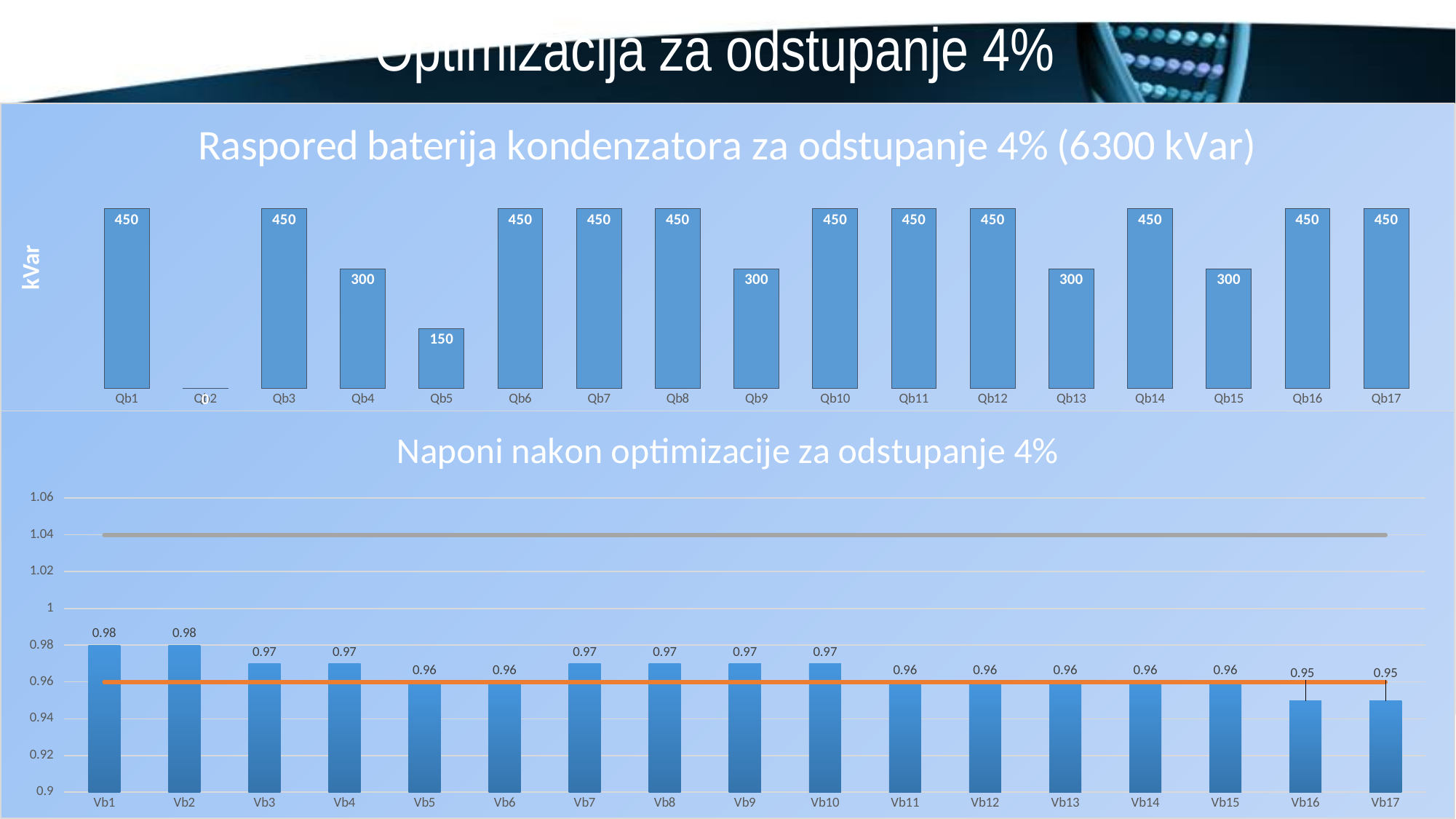
In the chart 'Naponi nakon optimizacije za odstupanje 4%', do the bar values generally rise or fall from Vb1 to Vb17? Fall In the chart 'Raspored baterija kondenzatora za odstupanje 4% (6300 kVar)', how many categories are shown on the x axis? 17 In the chart 'Naponi nakon optimizacije za odstupanje 4%', what is the difference between the values for Vb1 and Vb17? 0.03 In the chart 'Raspored baterija kondenzatora za odstupanje 4% (6300 kVar)', which category has the lowest value? Qb2 In the chart 'Naponi nakon optimizacije za odstupanje 4%', what kind of chart is used to show the Vb values? Bar chart In the chart 'Raspored baterija kondenzatora za odstupanje 4% (6300 kVar)', which is larger, the value for Qb9 or the value for Qb10? Qb10 In the chart 'Raspored baterija kondenzatora za odstupanje 4% (6300 kVar)', what is the value for Qb5? 150 In the chart 'Raspored baterija kondenzatora za odstupanje 4% (6300 kVar)', what is the value for Qb13? 300 In the chart 'Naponi nakon optimizacije za odstupanje 4%', what is the value for Vb3? 0.97 In the chart 'Raspored baterija kondenzatora za odstupanje 4% (6300 kVar)', what is the difference between the values for Qb1 and Qb4? 150 In the chart 'Naponi nakon optimizacije za odstupanje 4%', what is the value for Vb16? 0.95 In the chart 'Raspored baterija kondenzatora za odstupanje 4% (6300 kVar)', what is the label on the vertical axis? kVar